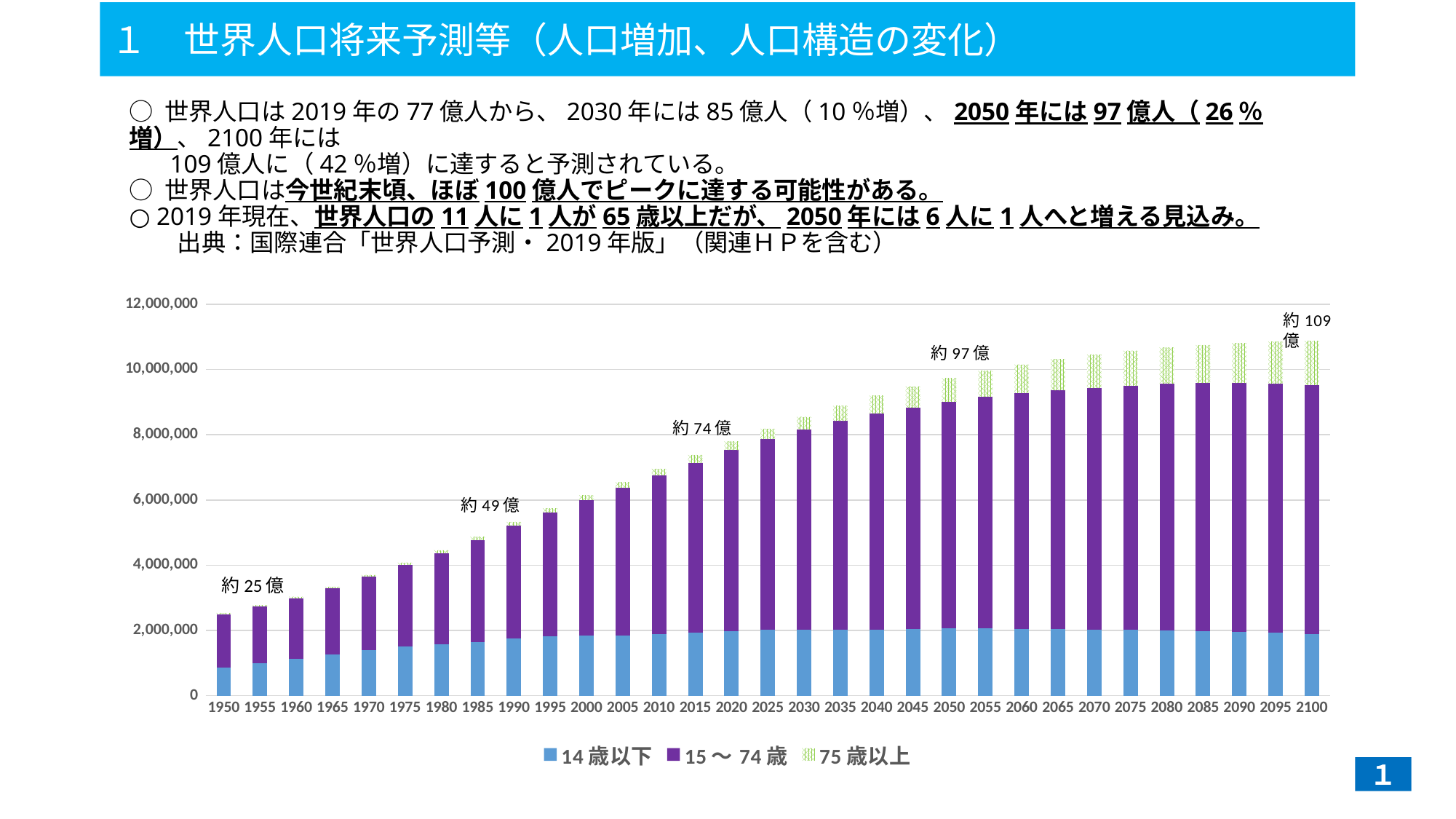
Which year has the taller stacked bar, 2000 or 2050? 2050 Which year has the shortest stacked bar in the chart? 1950 How many series does the chart legend list? 3 Do the total bar heights generally rise or fall from 1950 to 2100? rise Is the total bar height for 2100 greater or less than 10,000,000? greater How many years (categories) are plotted along the x axis of the chart? 31 Is the total bar height for 1970 greater or less than 4,000,000? less Which series in the legend is shown in blue? 14歳以下 What annotation is printed above the bar for 2050? 約97億 Is the total bar height for 2020 greater or less than 8,000,000? less What kind of chart is shown on the slide? stacked bar chart Which year has the tallest stacked bar in the chart? 2100